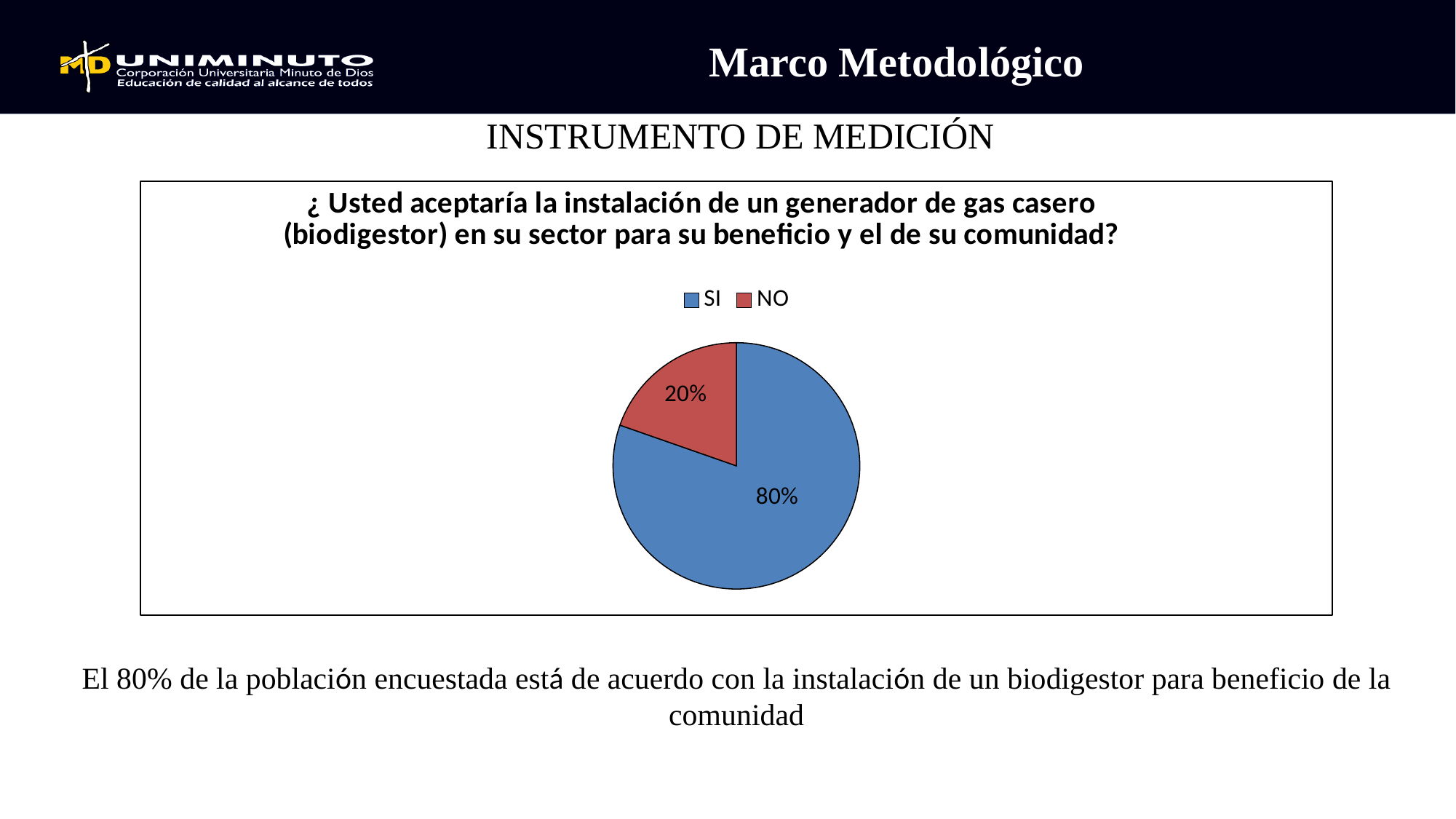
How many entries does the legend list? 2 What is the difference in percentage points between the SI and NO slices? 60 How many slices does the pie chart have? 2 What kind of chart is shown on the slide? pie chart What is the total of the two slices shown in the pie chart? 100% What colour is the SI slice in the pie chart? blue Which slice is larger, SI or NO? SI Which category has the largest slice of the pie? SI What colour is the NO slice in the pie chart? red What share of the pie does the NO slice represent? 20% Which category has the smallest slice of the pie? NO What share of the pie does the SI slice represent? 80%